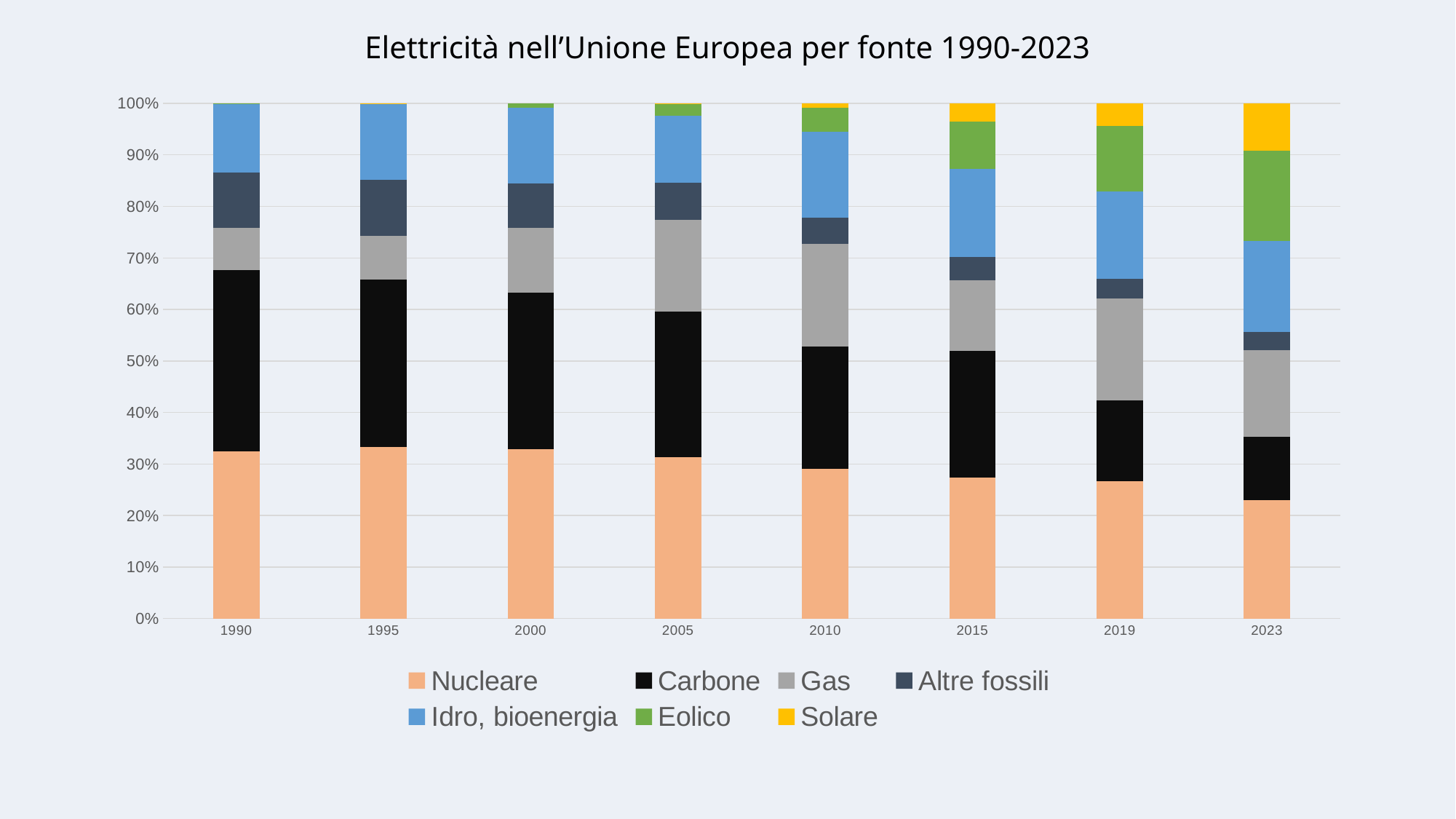
How many series does the legend list? 7 Is the Carbone share larger in 1990 or in 2023? 1990 Is the Nucleare share in 2023 greater or less than 30%? less What kind of chart is shown on the slide? Stacked bar chart Is the Carbone share in 2023 greater or less than 20%? less How many years are shown along the x axis of the chart? 8 Does the Solare share rise or fall from 1990 to 2023? rise Is the Nucleare share in 1990 greater or less than 30%? greater Which series is shown in yellow in the legend? Solare What is the title of the chart? Elettricità nell'Unione Europea per fonte 1990-2023 Which year has the smallest Carbone share? 2023 Which year has the largest Eolico share? 2023